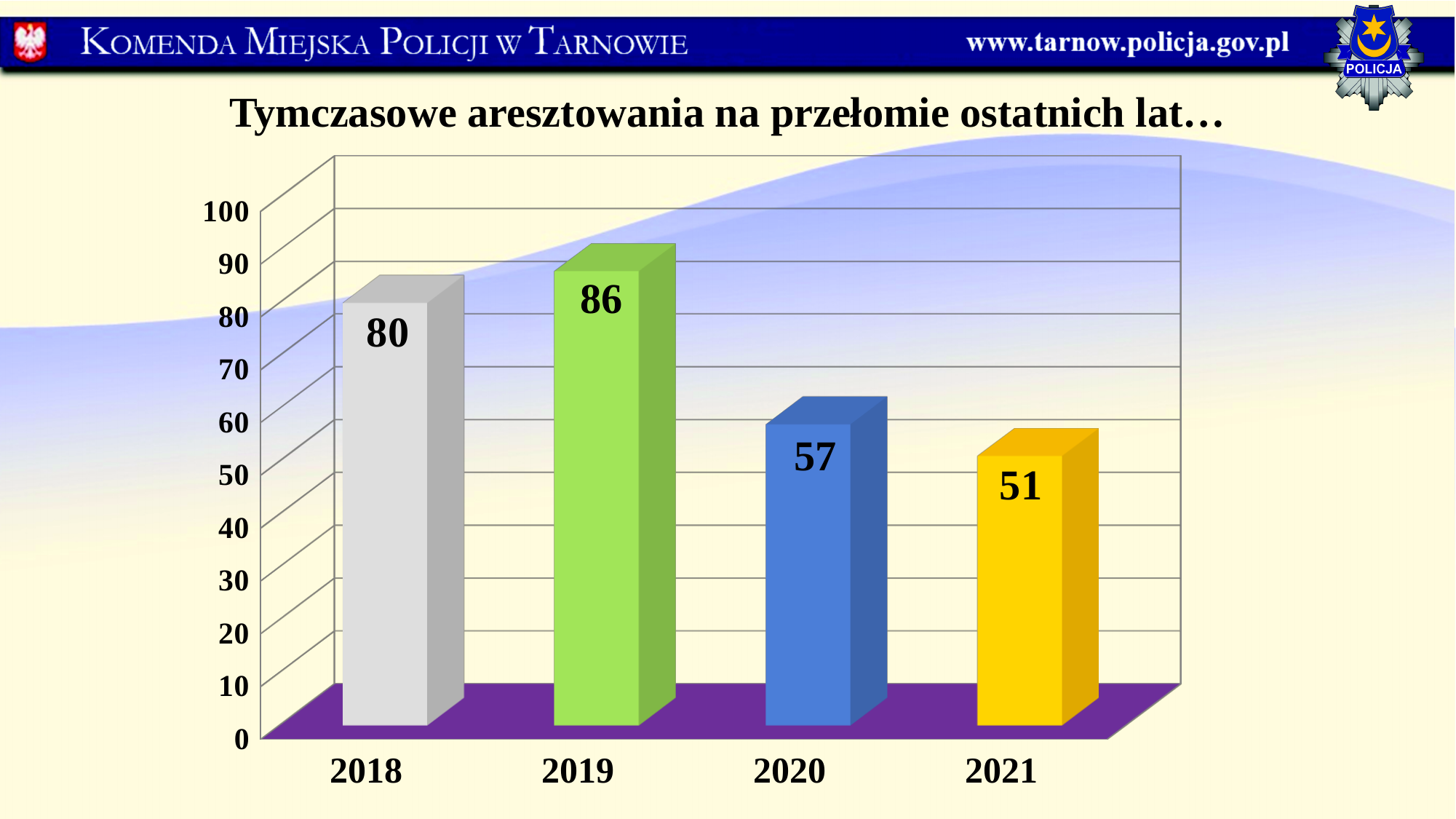
What is the value for 2020? 57 What kind of chart is shown on the slide? bar chart What is the value for 2018? 80 Which is larger, the value for 2018 or the value for 2020? 2018 What is the value for 2021? 51 What is the value for 2019? 86 What is the difference between the values for 2018 and 2020? 23 What is the title of the chart? Tymczasowe aresztowania na przełomie ostatnich lat… Which year has the highest value? 2019 What is the difference between the values for 2019 and 2021? 35 Which year has the lowest value? 2021 How many years are shown on the chart? 4